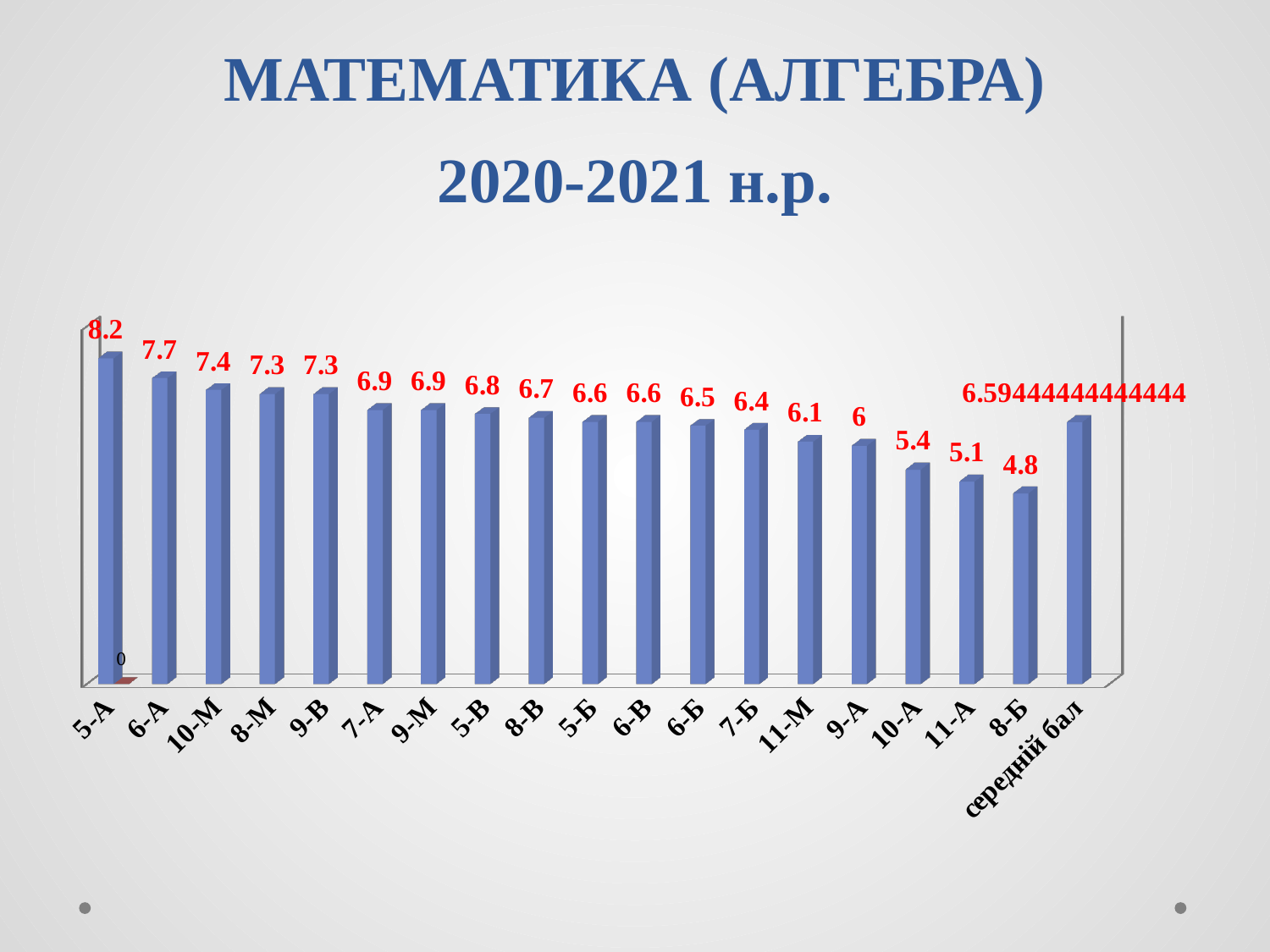
Which is larger, the value for 9-А or the value for 11-А? 9-А What is the value for 5-А? 8.2 Which class has the highest value? 5-А What is the value for 11-М? 6.1 What is the value for 8-Б? 4.8 Which class has the lowest value? 8-Б What is the title of the slide? МАТЕМАТИКА (АЛГЕБРА) 2020-2021 н.р. How many categories are shown on the x axis? 19 What kind of chart is shown on the slide? bar chart What is the difference between the values for 5-А and 8-Б? 3.4 What value is shown for середній бал? 6.59444444444444 What is the difference between the values for 6-А and 10-А? 2.3